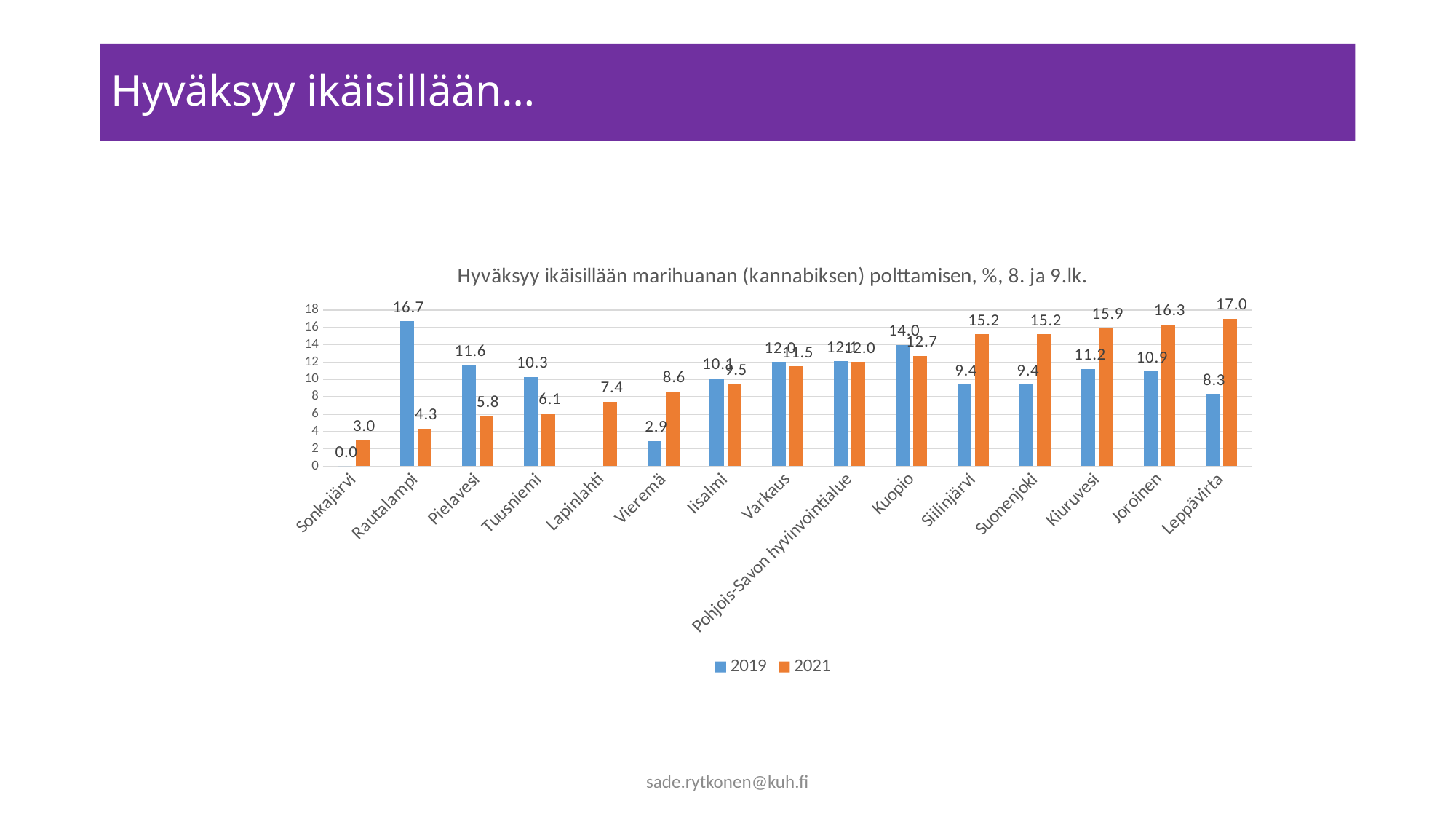
What is the 2019 value for Rautalampi? 16.7 What colour are the bars for the 2021 series? orange What is the 2021 value for Leppävirta? 17.0 What type of chart is shown on the slide? bar chart What is the 2021 value for Lapinlahti? 7.4 Is the 2021 value for Joroinen greater or less than 14? greater How many series does the legend list? 2 Which category has the lowest 2019 value? Sonkajärvi Which is larger for Kuopio, the 2019 value or the 2021 value? 2019 What is the difference between the 2021 and 2019 values for Siilinjärvi? 5.8 Which category has the highest 2021 value? Leppävirta How many municipalities/categories are shown on the x axis? 15